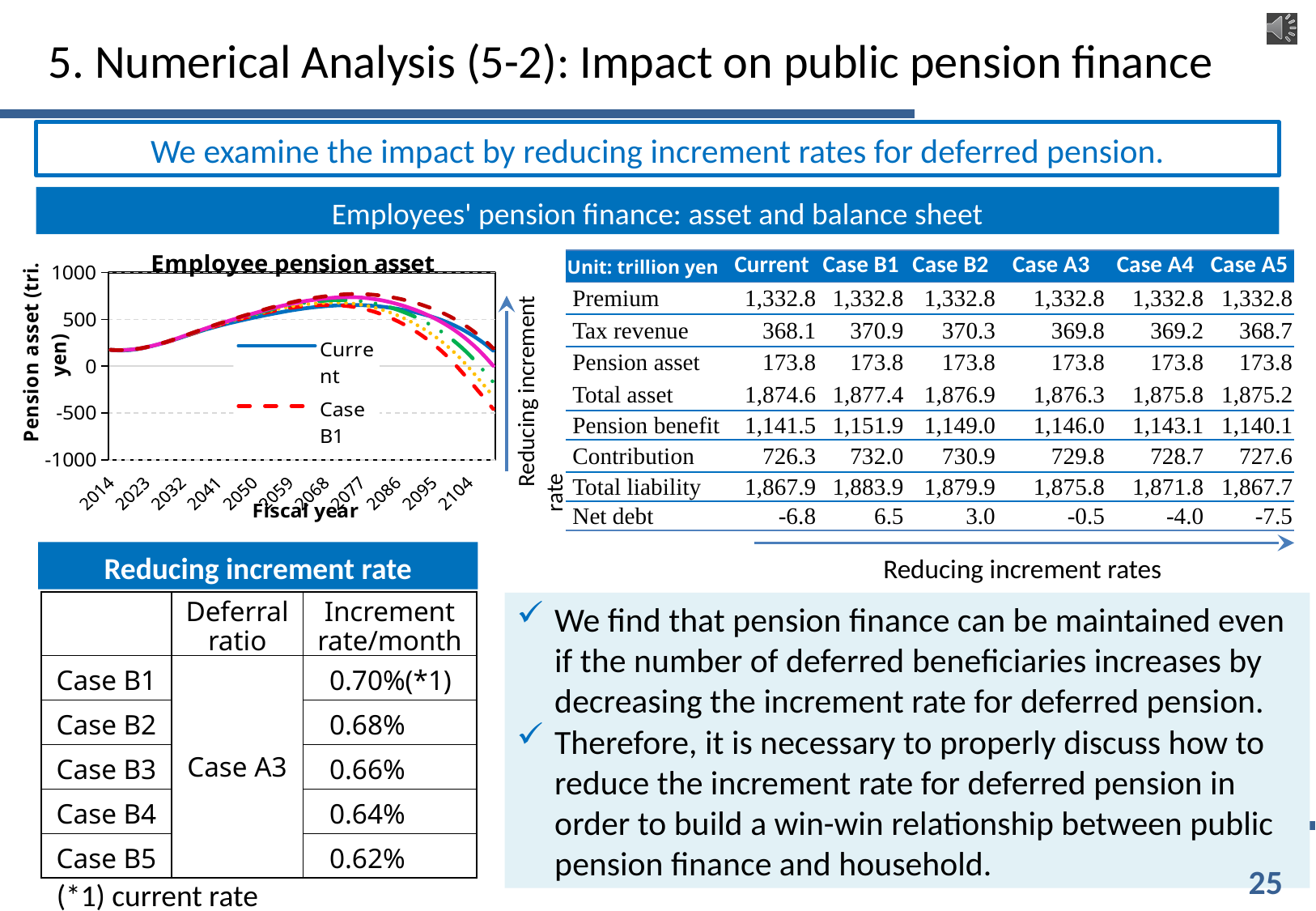
Is the value of the Case B1 series in 2104 greater or less than 0? less Which two series are named in the chart's legend? Current and Case B1 What is the title of the chart on the slide? Employee pension asset How many fiscal year tick labels are shown on the x axis of the chart? 11 What is the highest value shown on the y axis of the chart? 1000 What is the first fiscal year shown on the x axis of the chart? 2014 Does the Current series rise or fall between 2014 and 2068? rise What is the last fiscal year shown on the x axis of the chart? 2104 Is the value of the Current series in 2014 greater or less than 500? less What kind of chart is the "Employee pension asset" chart? line chart Does the Case B1 series rise or fall between 2077 and 2104? fall In 2086, which series is higher, Current or Case B1? Current